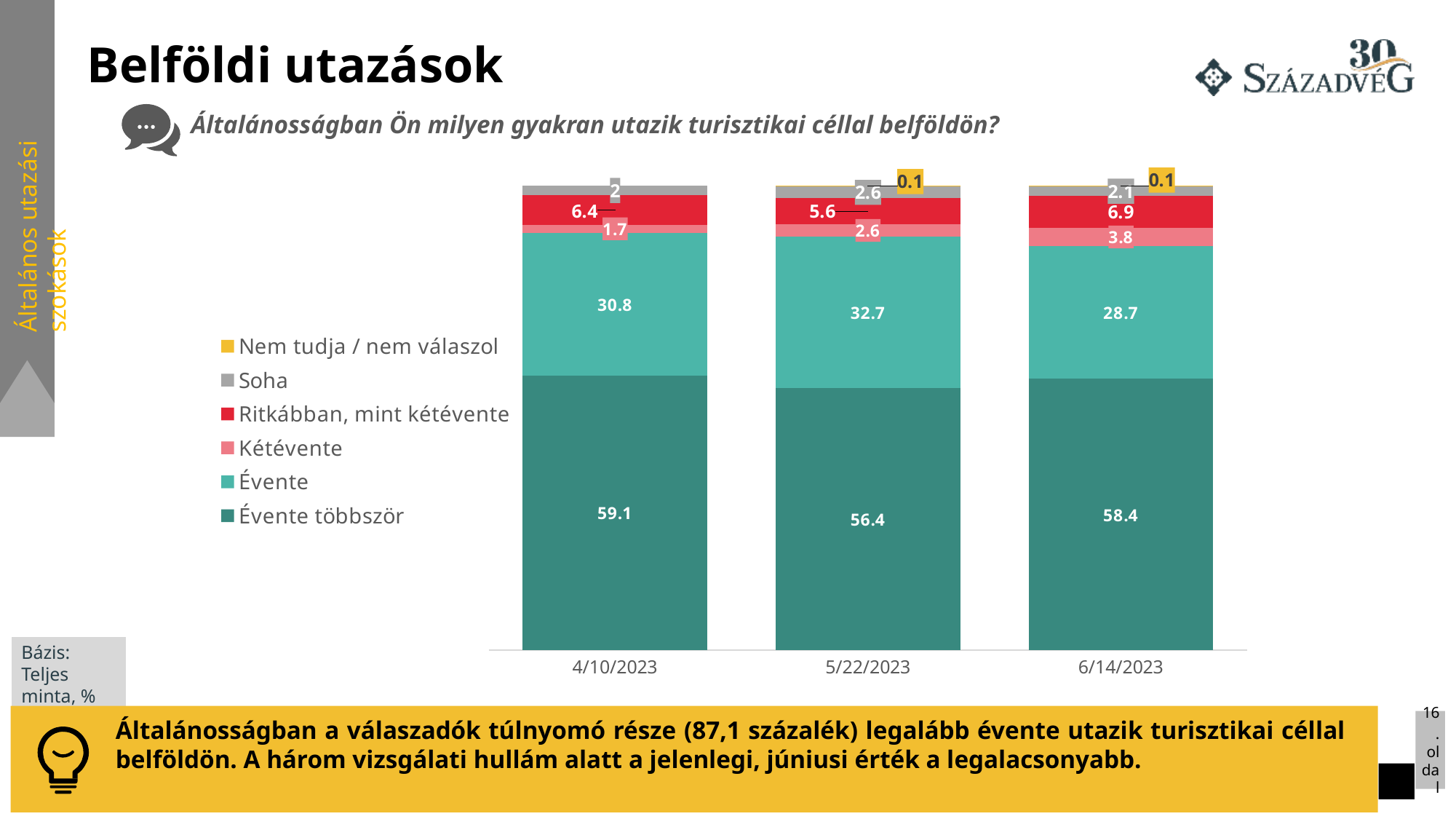
What is the value for "Ritkábban, mint kétévente" on 5/22/2023? 5.6 What is the difference between the "Évente többször" values on 4/10/2023 and 6/14/2023? 0.7 What is the total of the stacked bar for 6/14/2023? 100 What is the value for "Évente" on 5/22/2023? 32.7 Which is larger: the "Soha" value on 5/22/2023 or on 6/14/2023? 5/22/2023 How many series does the legend list? 6 What type of chart is shown on the slide? Stacked bar chart What is the value for "Évente többször" on 4/10/2023? 59.1 On which date is the "Évente" value the highest? 5/22/2023 What is the value for "Kétévente" on 6/14/2023? 3.8 How many dates (categories) are shown on the x axis? 3 On which date is the "Évente többször" value the lowest? 5/22/2023